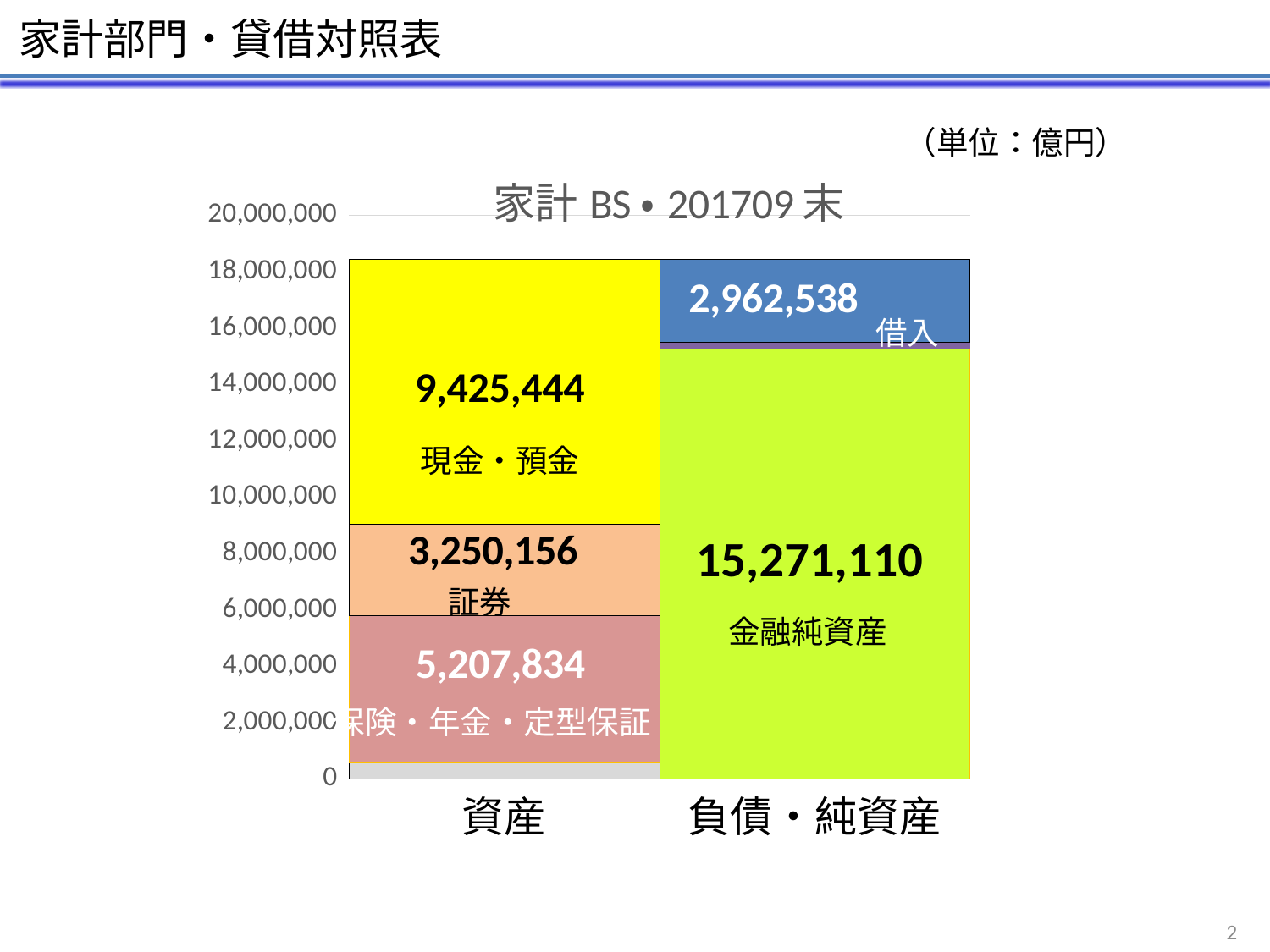
What is the value of 現金・預金 in the 資産 bar? 9,425,444 Which is larger, 保険・年金・定型保証 or 証券? 保険・年金・定型保証 What is the difference between 金融純資産 and 借入? 12,308,572 What is the value of 保険・年金・定型保証 in the 資産 bar? 5,207,834 What is the value of 証券 in the 資産 bar? 3,250,156 What is the value of 借入 in the 負債・純資産 bar? 2,962,538 What kind of chart is shown on the slide? Stacked bar chart Which labeled segment of the 資産 bar has the smallest value? 証券 Which labeled segment of the 資産 bar has the largest value? 現金・預金 What is the difference between 現金・預金 and 証券? 6,175,288 What is the title of the chart? 家計 BS・201709 末 What is the value of 金融純資産 in the 負債・純資産 bar? 15,271,110